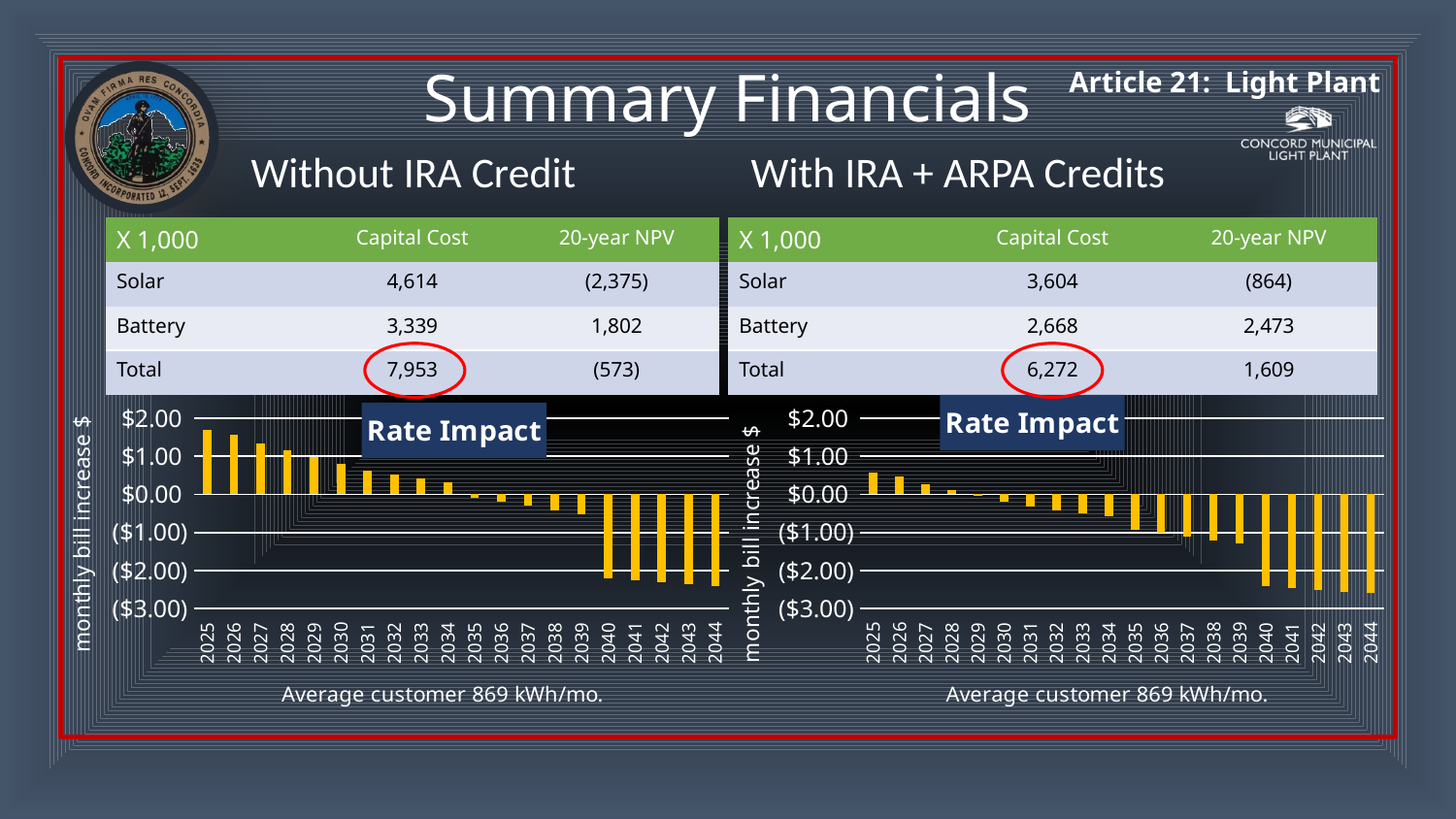
What kind of chart is the Rate Impact chart under "Without IRA Credit"? bar chart In the Rate Impact chart under "Without IRA Credit", is the value for 2030 greater or less than $0.00? greater In the Rate Impact chart under "With IRA + ARPA Credits", is the value for 2042 greater or less than ($1.00)? less In the Rate Impact chart under "Without IRA Credit", which year has the highest monthly bill increase? 2025 In the Rate Impact chart under "With IRA + ARPA Credits", which is larger, the value for 2025 or the value for 2035? 2025 In the Rate Impact chart under "With IRA + ARPA Credits", is the value for 2035 greater or less than $0.00? less How many years are shown on the x axis of the Rate Impact chart under "With IRA + ARPA Credits"? 20 What is the y-axis label on the Rate Impact chart under "Without IRA Credit"? monthly bill increase $ In the Rate Impact chart under "Without IRA Credit", do the values generally rise or fall from 2025 to 2044? fall